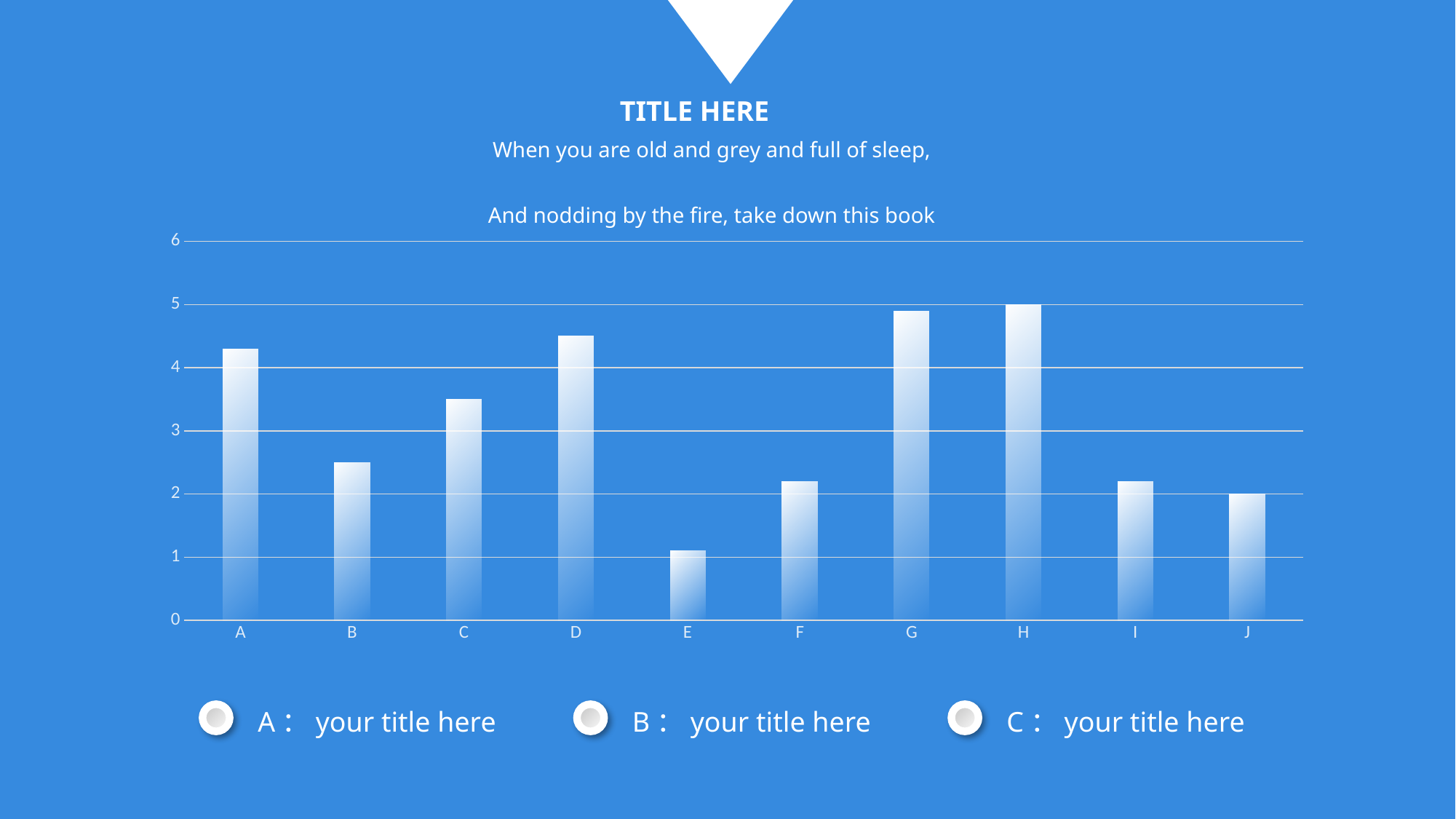
What is the title shown above the chart? TITLE HERE What is the value for J? 2 Is the value for A greater or less than 4? greater What kind of chart is shown on the slide? bar chart Which category has the lowest bar? E Is the value for G greater or less than 4? greater Which is larger, the value for D or the value for B? D How many categories are plotted on the x axis? 10 Is the value for E greater or less than 2? less Which is larger, the value for F or the value for A? A What is the value for H? 5